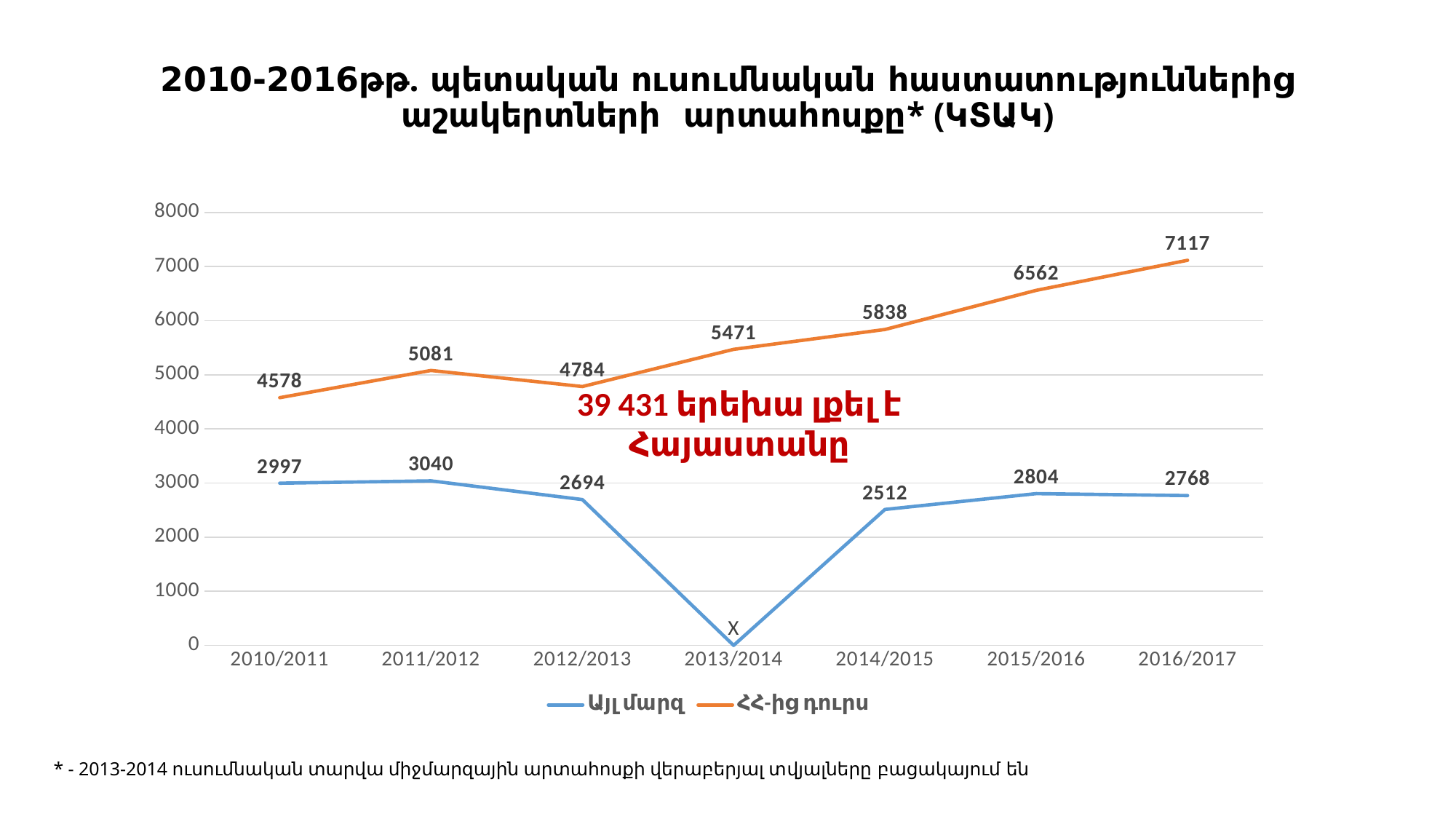
Which series has the larger value in 2014/2015, Այլ մարզ or ՀՀ-ից դուրս? ՀՀ-ից դուրս Does the ՀՀ-ից դուրս series generally rise or fall from 2012/2013 to 2016/2017? rise What is the value for ՀՀ-ից դուրս in 2012/2013? 4784 What type of chart is shown on the slide? line chart How many academic years are shown on the x axis? 7 Which academic year has no data label for the Այլ մարզ series, marked with an X? 2013/2014 What is the value for ՀՀ-ից դուրս in 2016/2017? 7117 What is the value for Այլ մարզ in 2011/2012? 3040 What is the difference between the ՀՀ-ից դուրս values for 2016/2017 and 2015/2016? 555 How many series does the legend list? 2 In which academic year is the ՀՀ-ից դուրս series highest? 2016/2017 In which academic year is the ՀՀ-ից դուրս series lowest? 2010/2011